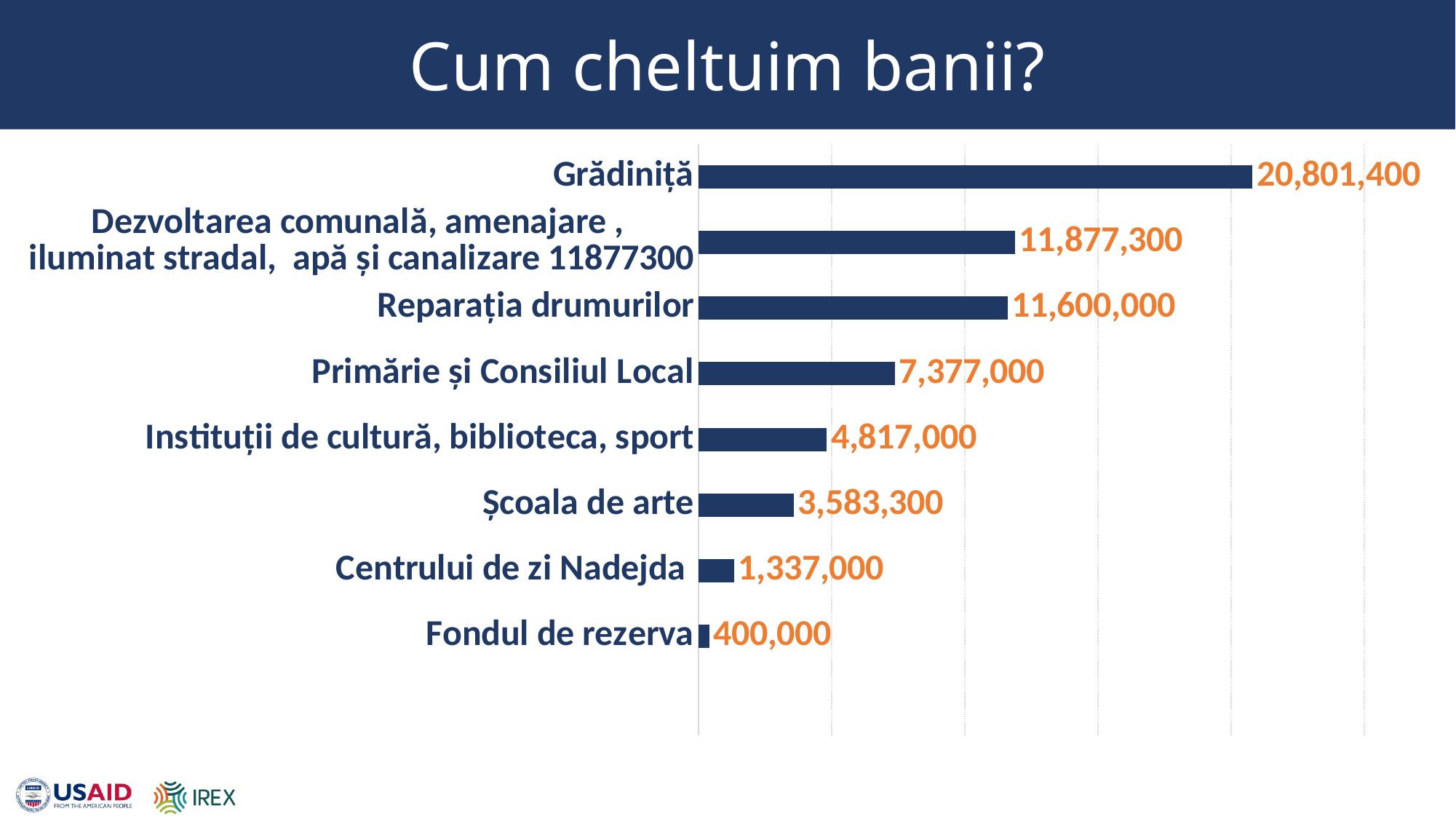
What is the difference between the values for Grădiniță and Dezvoltarea comunală, amenajare, iluminat stradal, apă și canalizare? 8,924,100 What type of chart is shown on the slide? Bar chart What is the value for Centrului de zi Nadejda? 1,337,000 Which category has the highest value? Grădiniță Which category has the lowest value? Fondul de rezerva What is the difference between the values for Primărie și Consiliul Local and Instituții de cultură, biblioteca, sport? 2,560,000 What is the value for Grădiniță? 20,801,400 Which is larger, the value for Dezvoltarea comunală, amenajare, iluminat stradal, apă și canalizare or the value for Reparația drumurilor? Dezvoltarea comunală, amenajare, iluminat stradal, apă și canalizare What is the value for Primărie și Consiliul Local? 7,377,000 What is the value for Reparația drumurilor? 11,600,000 How many categories are shown in the chart? 8 What is the value for Școala de arte? 3,583,300